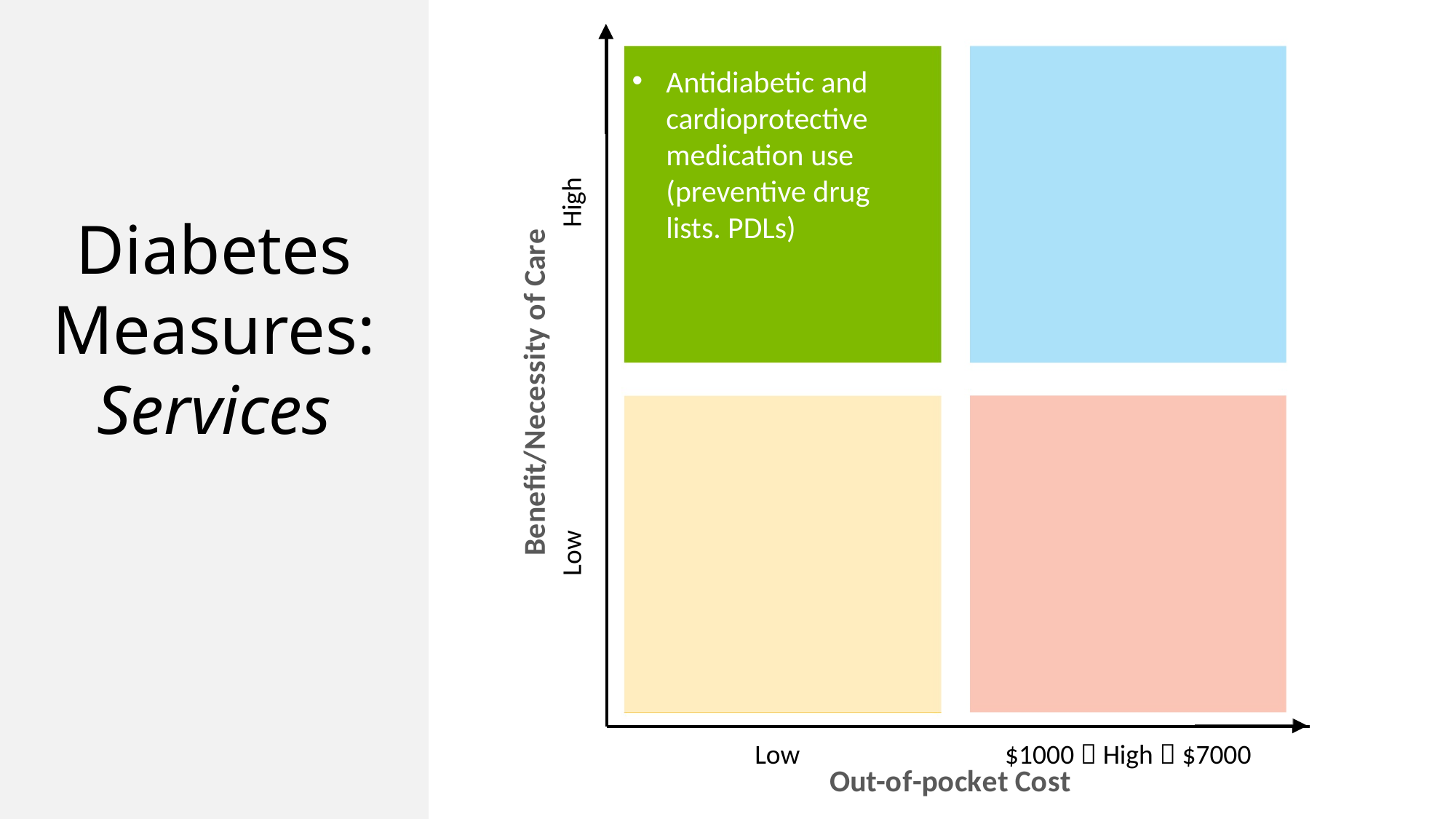
How many quadrants does the diagram contain? 4 What is the label of the horizontal axis? Out-of-pocket Cost In which quadrant (by benefit and cost) is 'Antidiabetic and cardioprotective medication use (preventive drug lists. PDLs)' placed? High benefit, low cost What is the label of the vertical axis? Benefit/Necessity of Care What cost range is shown for the 'High' end of the Out-of-pocket Cost axis? $1000 to $7000 What kind of chart is shown on the slide? A 2x2 quadrant (matrix) diagram What colour is the quadrant that contains the text about antidiabetic and cardioprotective medication use? Green